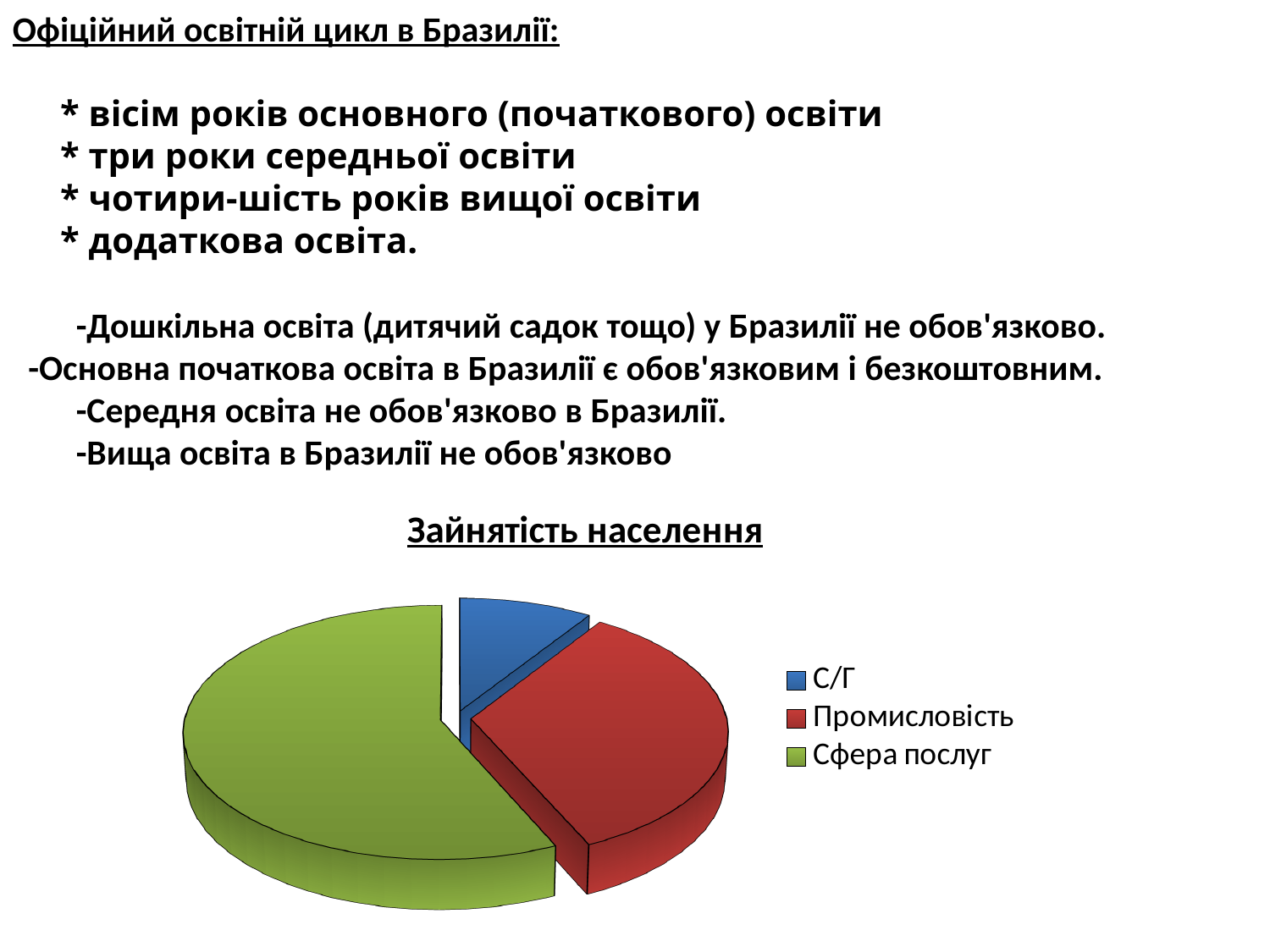
How many slices does the pie chart have? 3 What is the title of the chart on the slide? Зайнятість населення Does the Сфера послуг slice take up more or less than half of the pie chart? more Which slice is larger in the pie chart, Промисловість or С/Г? Промисловість Which category has the largest slice in the pie chart? Сфера послуг What kind of chart is shown under the title "Зайнятість населення"? pie chart What colour is the Сфера послуг slice in the pie chart? green Which slice is larger in the pie chart, Сфера послуг or Промисловість? Сфера послуг Which category has the smallest slice in the pie chart? С/Г How many entries does the legend of the pie chart list? 3